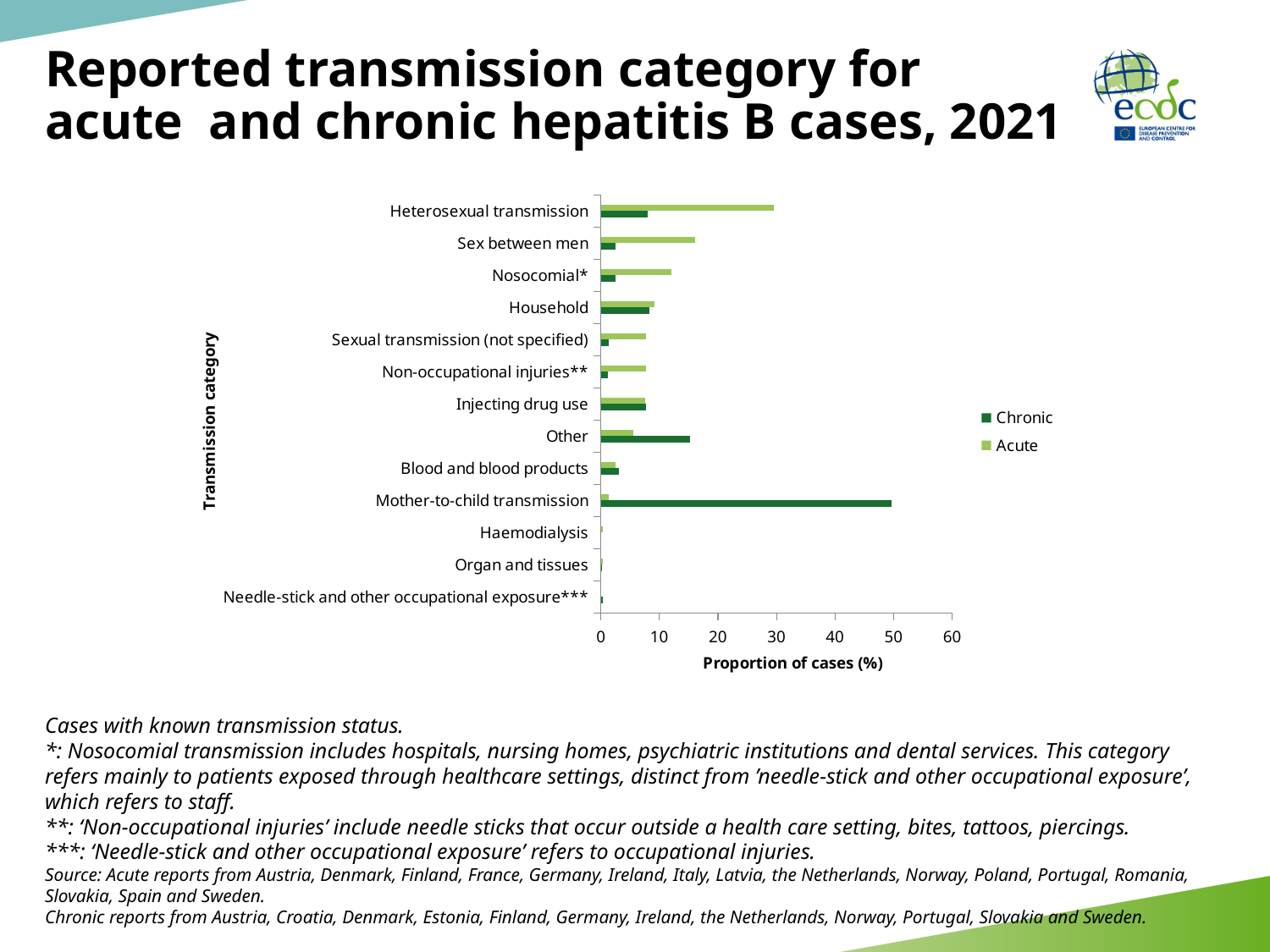
What kind of chart is shown on the slide? Bar chart For Nosocomial*, which series has the larger value, Chronic or Acute? Acute How many transmission categories are shown on the y axis? 13 Is the Chronic value for Other greater or less than 10? greater Which transmission category has the highest proportion of Acute cases? Heterosexual transmission What is the label of the x axis? Proportion of cases (%) How many series does the legend list? 2 Which transmission category has the highest proportion of Chronic cases? Mother-to-child transmission Is the Acute value for Heterosexual transmission greater or less than 20? greater Is the Acute value for Sex between men greater or less than 20? less For the Other category, which series has the larger value, Chronic or Acute? Chronic